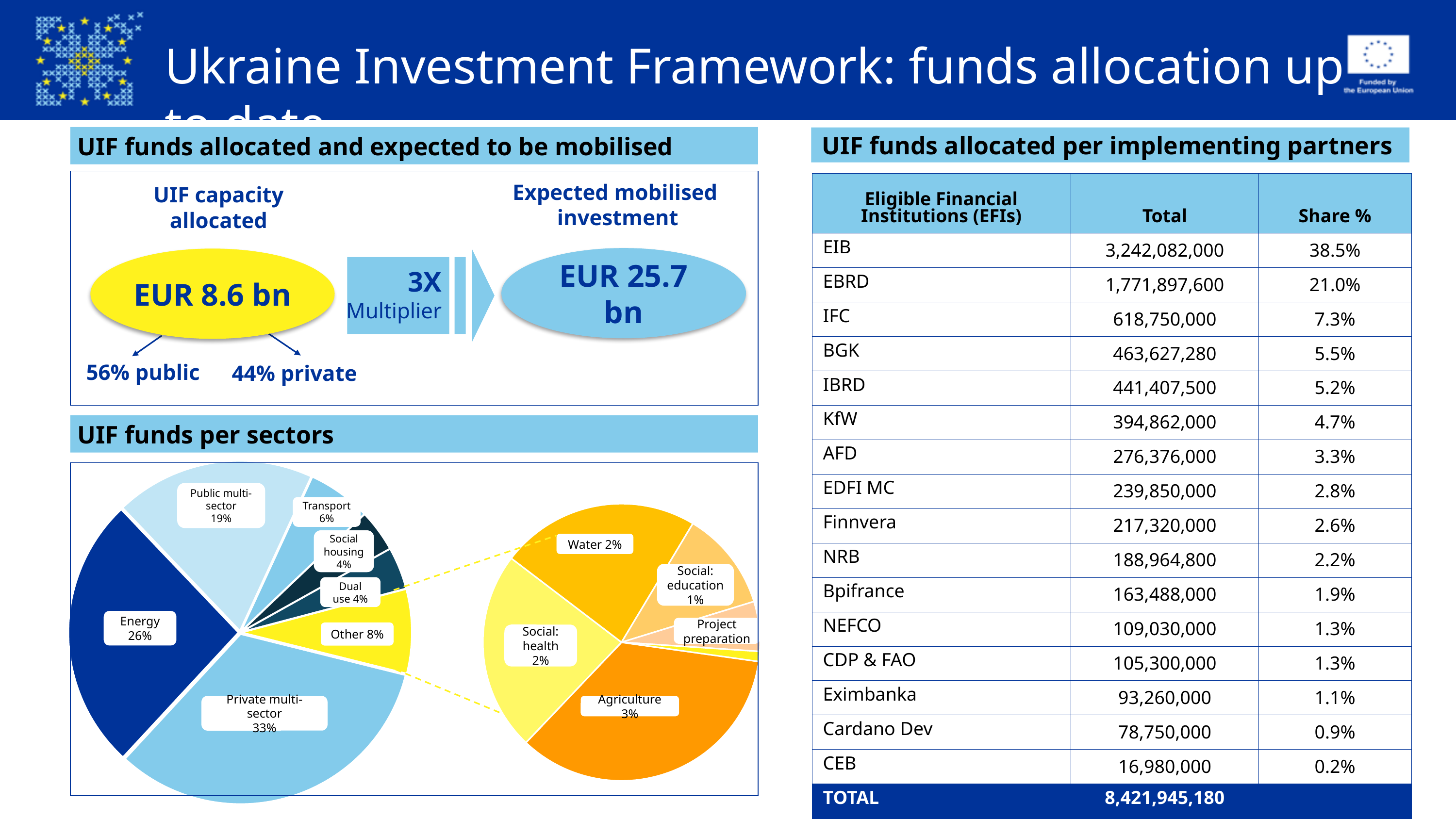
In the 'UIF funds per sectors' chart, what share of the pie is labelled 'Other'? 8% What is the title of the pie chart on the slide? UIF funds per sectors In the 'UIF funds per sectors' chart, what share of funds goes to Private multi-sector? 33% In the 'UIF funds per sectors' chart, what share of funds goes to Public multi-sector? 19% In the 'UIF funds per sectors' chart, which is larger: Energy or Public multi-sector? Energy In the 'UIF funds per sectors' chart, what share of funds goes to Agriculture? 3% In the 'UIF funds per sectors' chart, what share of funds goes to Energy? 26% In the 'UIF funds per sectors' chart, what kind of chart is used? pie chart In the 'UIF funds per sectors' chart, what share of funds goes to Transport? 6% In the 'UIF funds per sectors' chart, what share of funds goes to Water? 2% In the 'UIF funds per sectors' chart, how many percentage points larger is Private multi-sector than Energy? 7 In the 'UIF funds per sectors' chart, which sector has the largest share? Private multi-sector